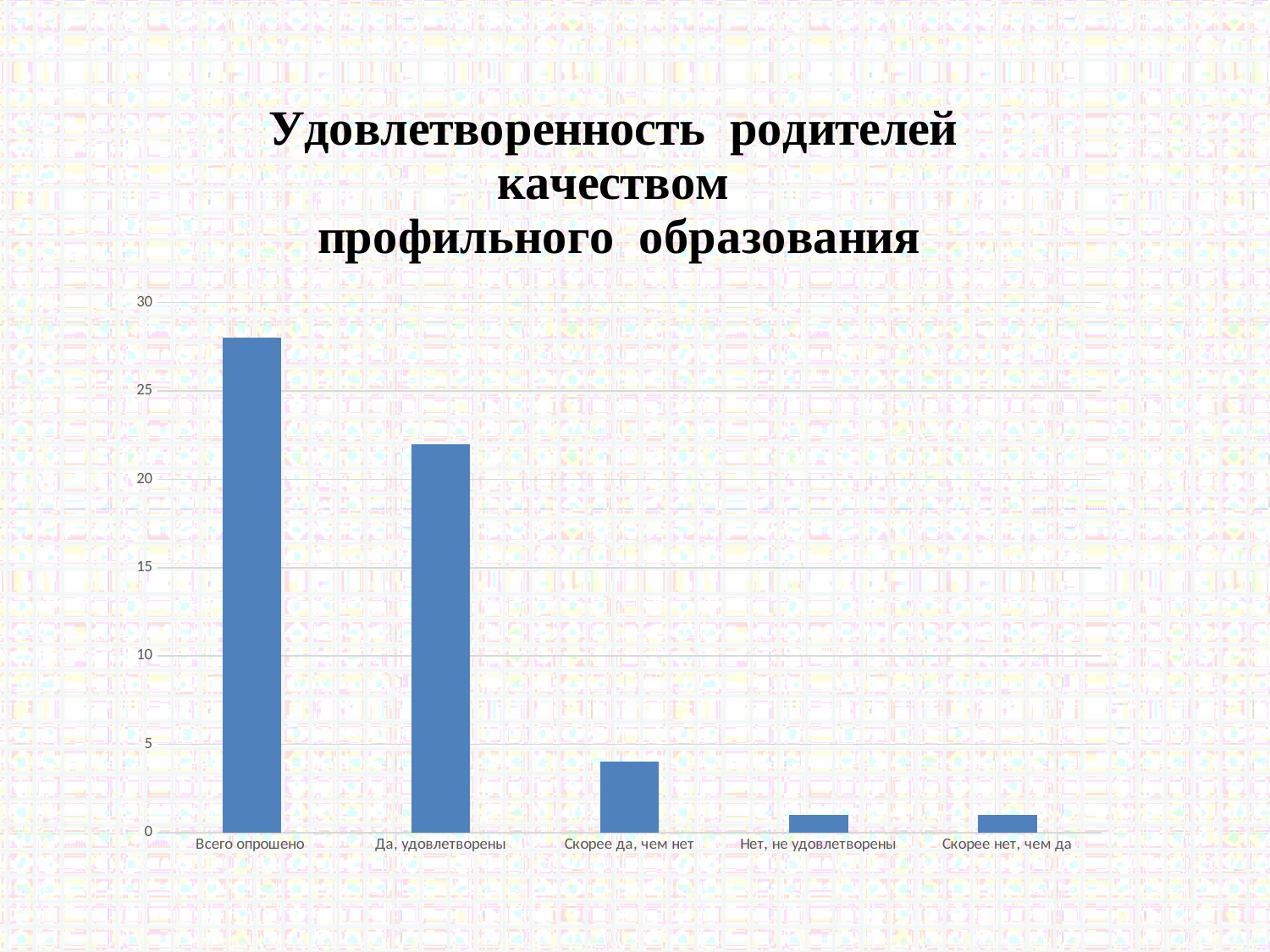
Is the value for "Да, удовлетворены" greater or less than 25? less How many categories are shown on the x axis of the chart? 5 Which category has the highest bar in the chart? Всего опрошено Is the value for "Всего опрошено" greater or less than 25? greater Is the value for "Да, удовлетворены" greater or less than 20? greater Which is larger: the value for "Да, удовлетворены" or the value for "Скорее да, чем нет"? Да, удовлетворены What is the title of the chart on the slide? Удовлетворенность родителей качеством профильного образования What kind of chart is shown on the slide? bar chart Which is larger: the value for "Скорее да, чем нет" or the value for "Скорее нет, чем да"? Скорее да, чем нет What is the highest value shown on the vertical axis of the chart? 30